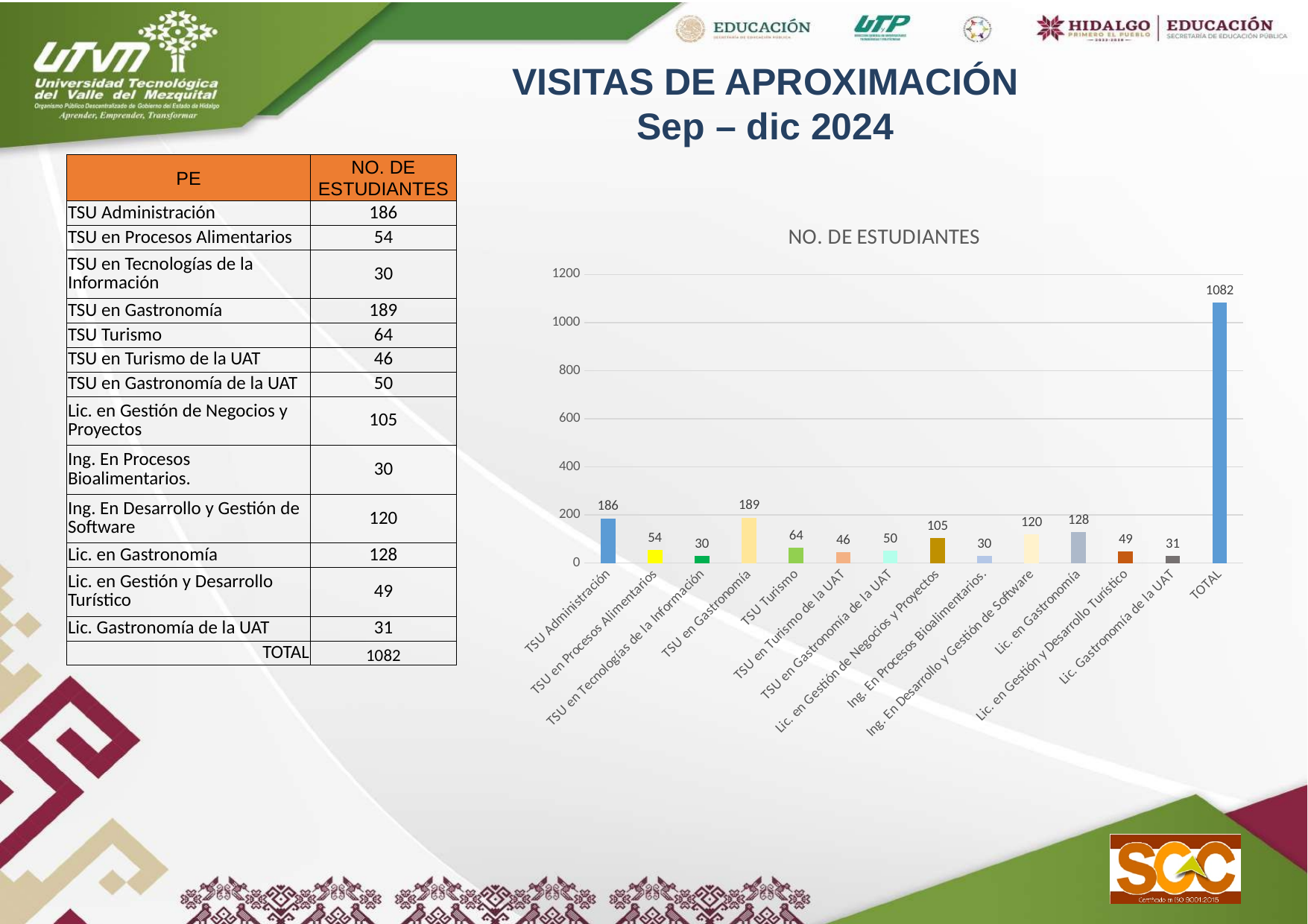
How many bars are plotted in the chart, including the TOTAL bar? 14 Excluding the TOTAL bar, which category has the highest value in the chart? TSU en Gastronomía What type of chart is shown on the slide? bar chart Is the value for the TOTAL bar greater or less than 1000? greater What is the value for Lic. en Gastronomía in the chart? 128 What is the value of the TOTAL bar in the chart? 1082 What is the difference between the values for Lic. en Gastronomía and Lic. en Gestión de Negocios y Proyectos? 23 What is the value for Ing. En Desarrollo y Gestión de Software in the chart? 120 Which is larger in the chart: TSU Turismo or TSU en Turismo de la UAT? TSU Turismo What is the value for TSU Administración in the chart? 186 What is the title of the chart? NO. DE ESTUDIANTES What is the difference between the values for TSU en Gastronomía and TSU Administración? 3